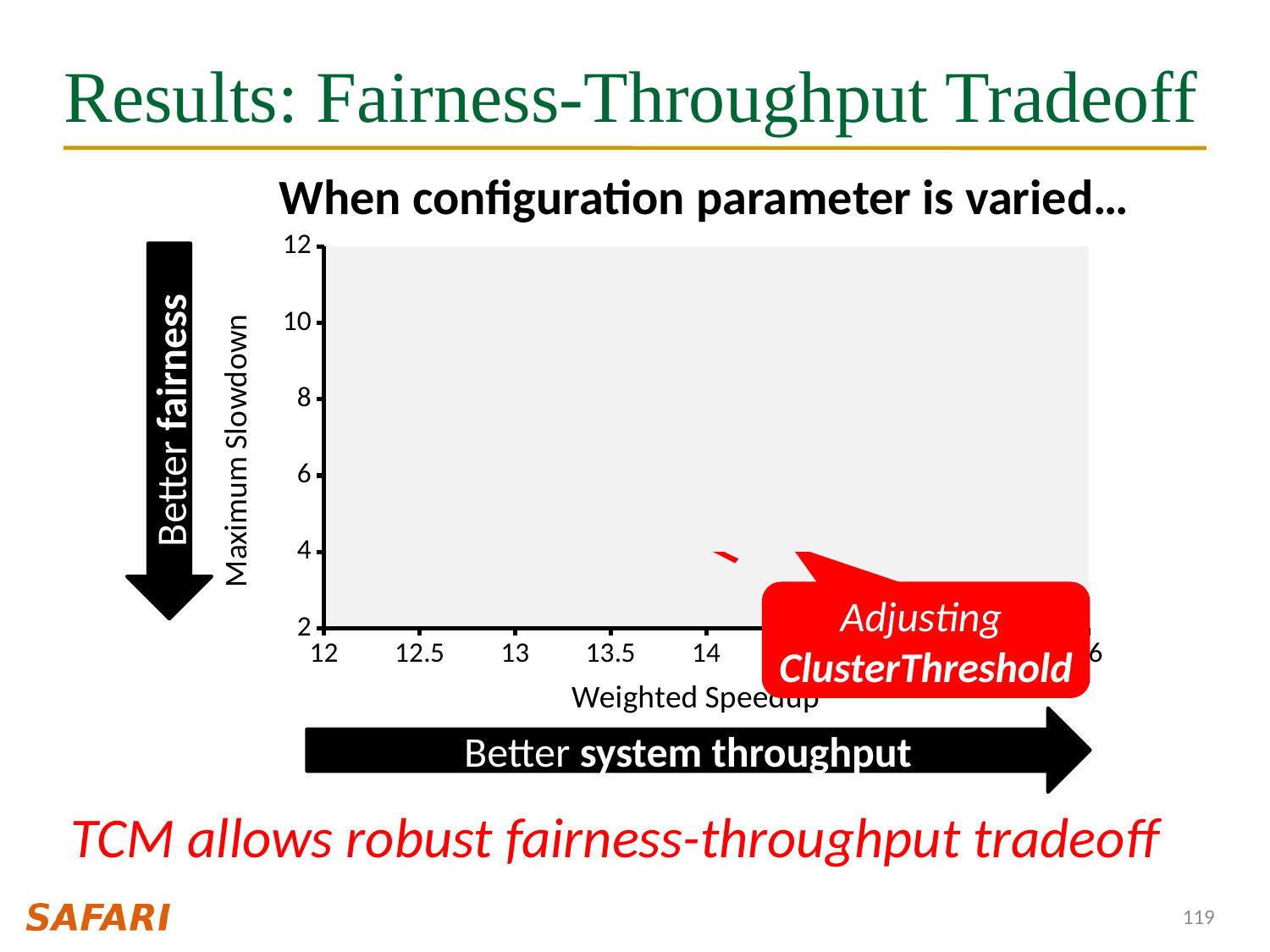
Is the Weighted Speedup of the visible red data point greater or less than 13? greater Is the Weighted Speedup of the visible red data point greater or less than 13.5? greater What kind of chart is shown on the slide? scatter chart Is the Maximum Slowdown of the visible red data point greater or less than 2? greater What is the label of the x axis of the chart? Weighted Speedup What is the label of the y axis of the chart? Maximum Slowdown